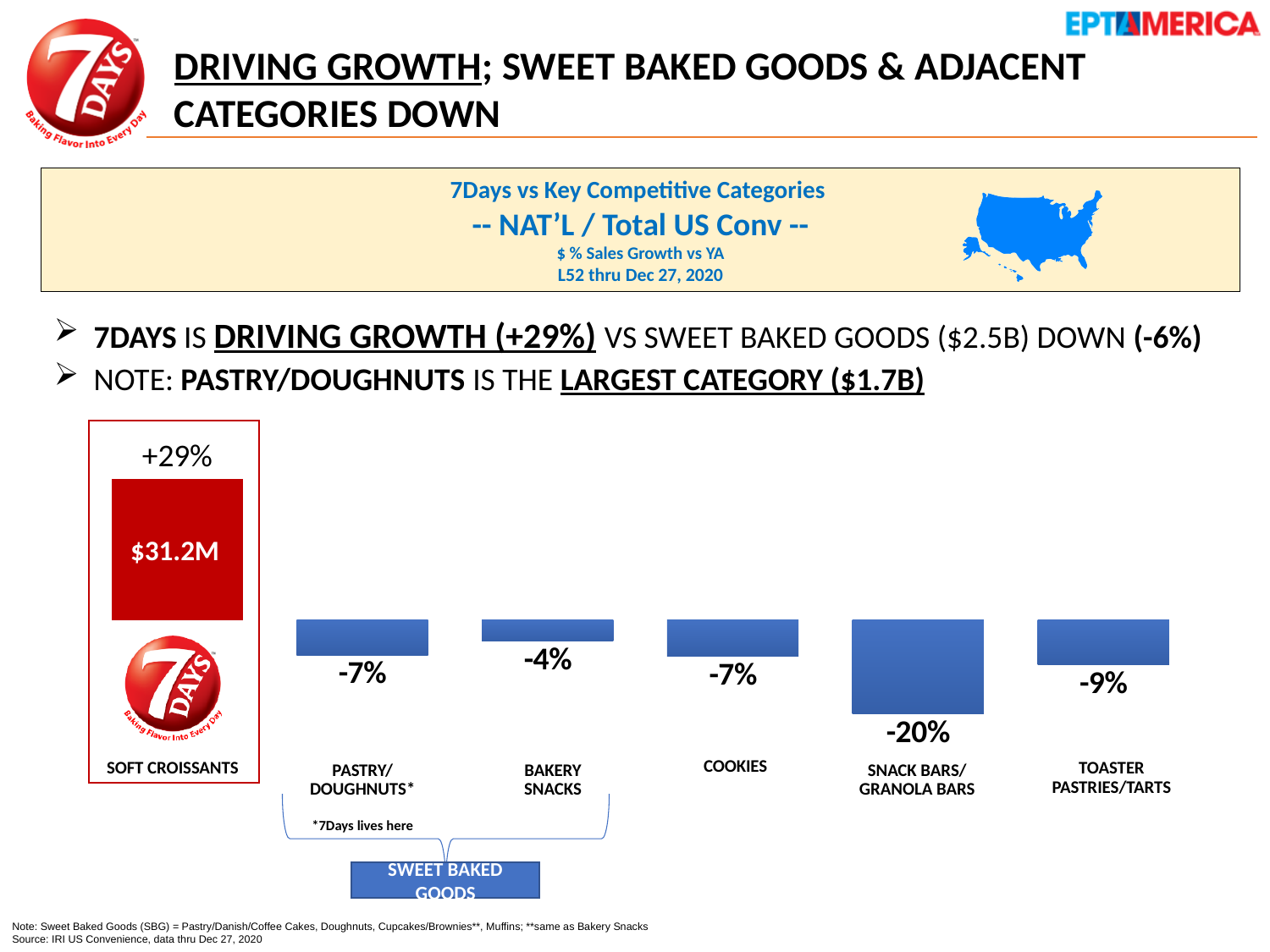
What dollar sales figure is printed on the Soft Croissants bar? $31.2M What is the sales growth shown for Snack Bars/Granola Bars? -20% How many categories are shown in the chart? 6 Which has the larger sales growth, Bakery Snacks or Toaster Pastries/Tarts? Bakery Snacks What is the $ % sales growth vs YA shown for Soft Croissants? +29% Which category has the highest sales growth in the chart? Soft Croissants Which two categories are grouped under the Sweet Baked Goods bracket below the chart? Pastry/Doughnuts and Bakery Snacks What is the difference in percentage points between the growth for Soft Croissants and Snack Bars/Granola Bars? 49 percentage points What is the sales growth shown for Toaster Pastries/Tarts? -9% What kind of chart is shown on the slide? Bar chart Which category has the lowest sales growth in the chart? Snack Bars/Granola Bars What is the sales growth shown for Bakery Snacks? -4%